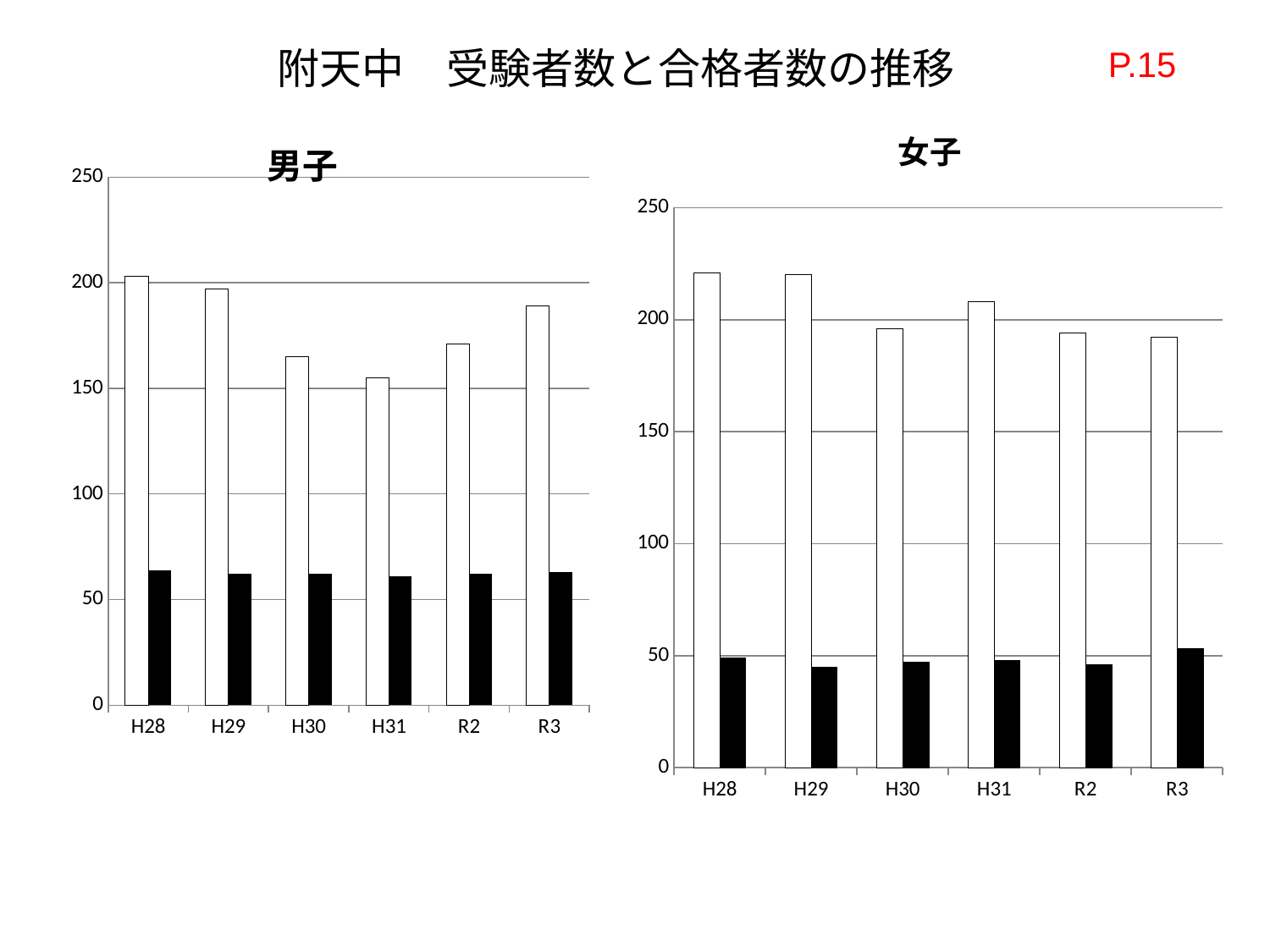
How many categories are shown on the x axis of the 女子 chart? 6 In the 男子 chart, is the white bar for H28 greater or less than 200? greater In the 男子 chart, which category has the tallest white bar? H28 In the 女子 chart, which category has the tallest black bar? R3 In the 女子 chart, is the black bar for H29 greater or less than 50? less In the 男子 chart, is the white bar for H30 greater or less than 200? less In the 男子 chart, which category has the shortest white bar? H31 In the 女子 chart, which white bar is taller, H30 or H31? H31 What kind of chart is the 男子 chart? bar chart What is the title of the chart on the right side of the slide? 女子 In the 男子 chart, which white bar is taller, H28 or H31? H28